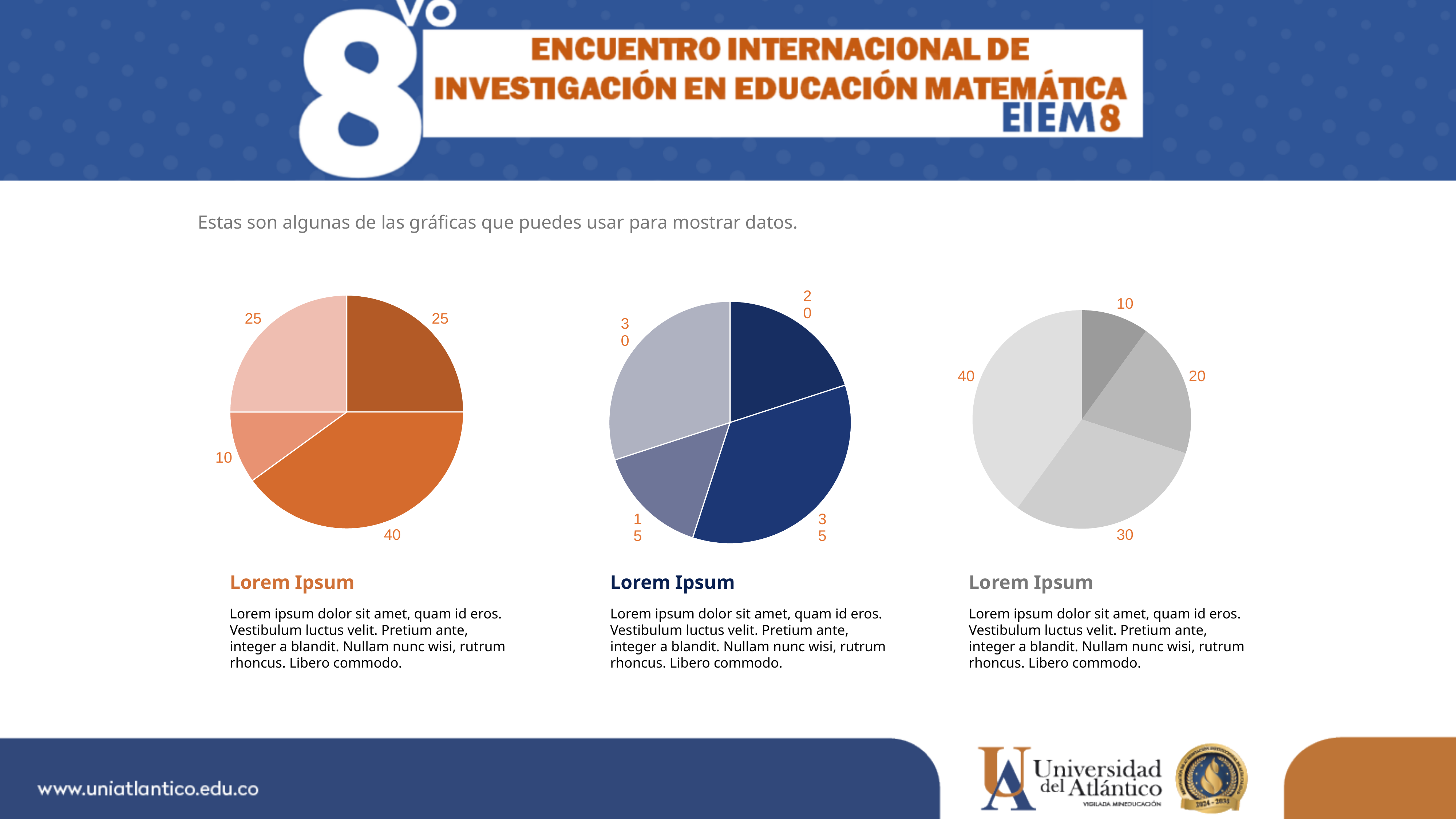
How many pie charts are shown on the slide? 3 In the middle (blue) pie chart, what is the largest slice value? 35 In the right (grey) pie chart, what is the largest slice value? 40 In the right (grey) pie chart, what value is labelled on the darkest grey slice? 10 In the left (orange) pie chart, what is the largest slice value? 40 What kind of chart is the left chart on the slide? pie chart In the left (orange) pie chart, what is the total of all slice values? 100 In the middle (blue) pie chart, what is the difference between the largest and smallest slice values? 20 In the left (orange) pie chart, what share of the pie does the slice labelled 40 represent? 40% In the left (orange) pie chart, what is the smallest slice value? 10 In the middle (blue) pie chart, what is the smallest slice value? 15 How many slices does the left (orange) pie chart have? 4